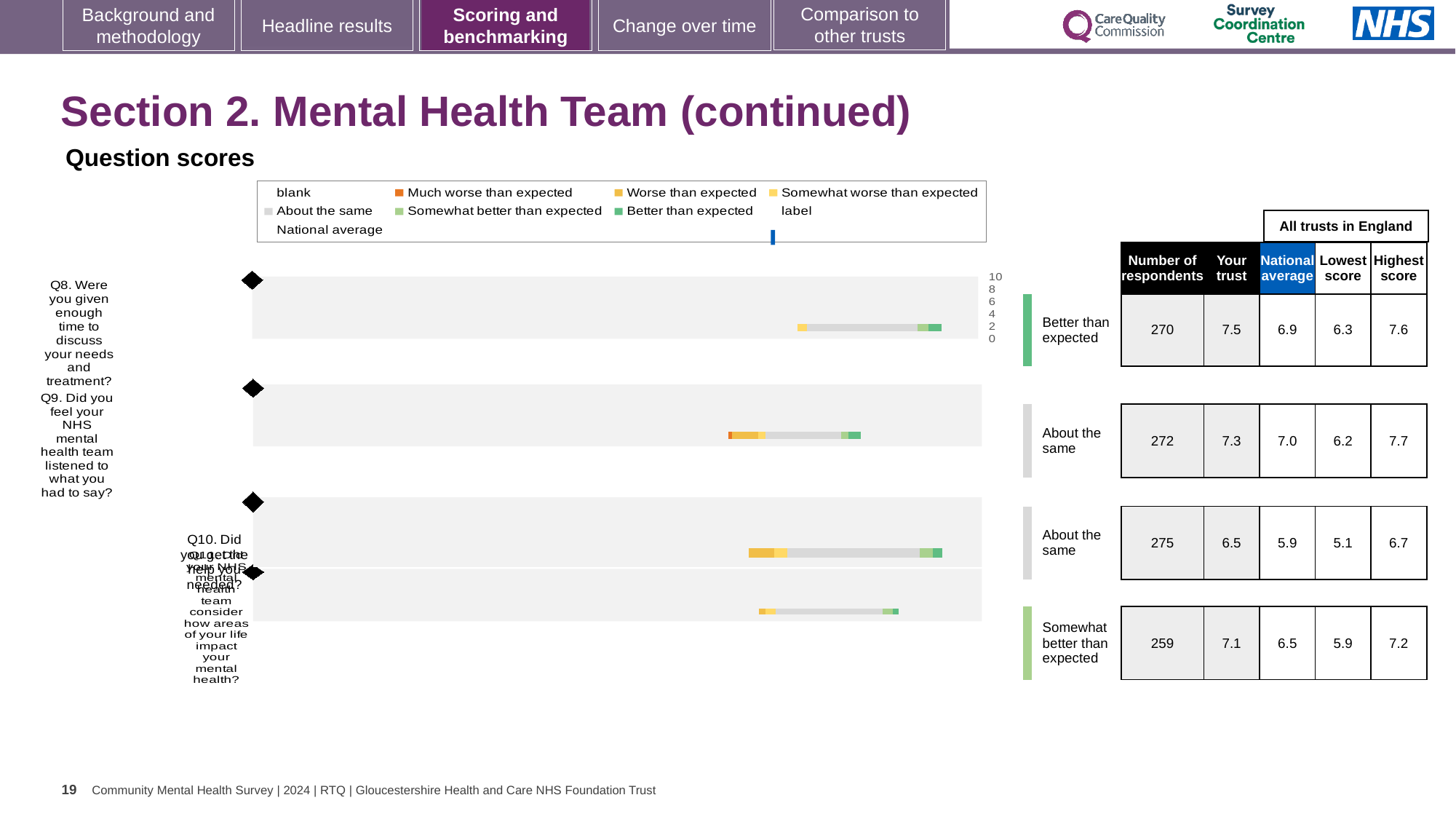
What benchmark category is shown for Q11? Somewhat better than expected How many respondents answered Q10 (Did you get the help you needed?)? 275 Which question has the lowest 'Your trust' score? Q10 Is the 'Your trust' score for Q9 higher or lower than the national average for Q9? higher What is the highest score among all trusts in England for Q11? 7.2 How many questions (bars) are plotted in the question scores chart? 4 What is the difference between the 'Your trust' score and the national average for Q8? 0.6 What kind of chart is used to show the question scores on this slide? bar chart What benchmark category is shown for Q8? Better than expected What is the 'Your trust' score for Q8 (Were you given enough time to discuss your needs and treatment?)? 7.5 What is the national average score for Q9 (Did you feel your NHS mental health team listened to what you had to say?)? 7.0 Which question has the highest number of respondents? Q10